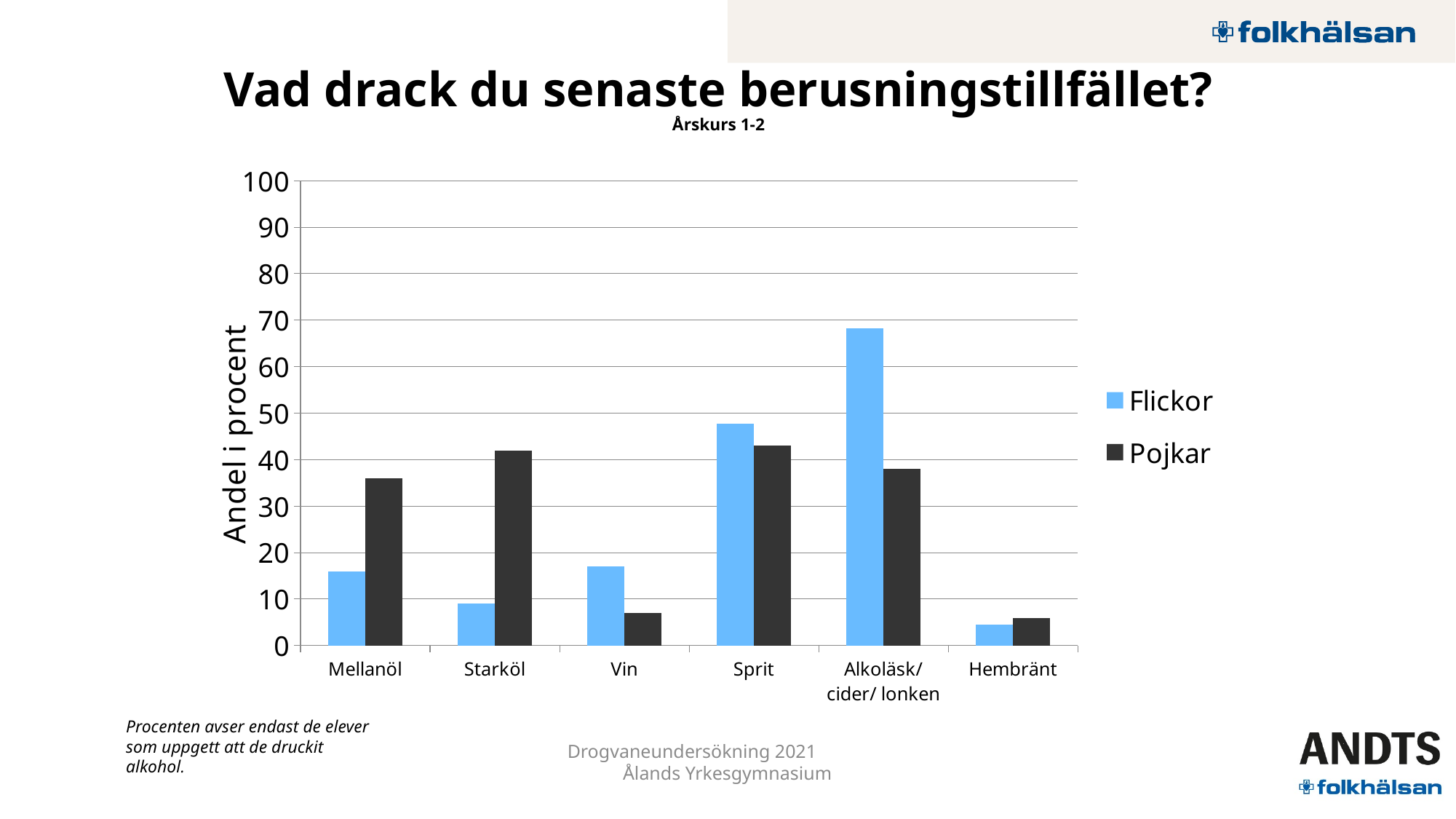
How many categories are shown on the x axis? 6 How many series does the legend list? 2 For Vin, which is larger: Flickor or Pojkar? Flickor For which category is the Flickor value highest? Alkoläsk/ cider/ lonken For Mellanöl, which is larger: Flickor or Pojkar? Pojkar Is the Flickor value for Mellanöl greater or less than 20? less Is the Flickor value for Alkoläsk/ cider/ lonken greater or less than 60? greater What is the label of the y axis? Andel i procent What kind of chart is shown on the slide? bar chart For which category is the Flickor value lowest? Hembränt Is the Pojkar value for Mellanöl greater or less than 30? greater For Alkoläsk/ cider/ lonken, which is larger: Flickor or Pojkar? Flickor